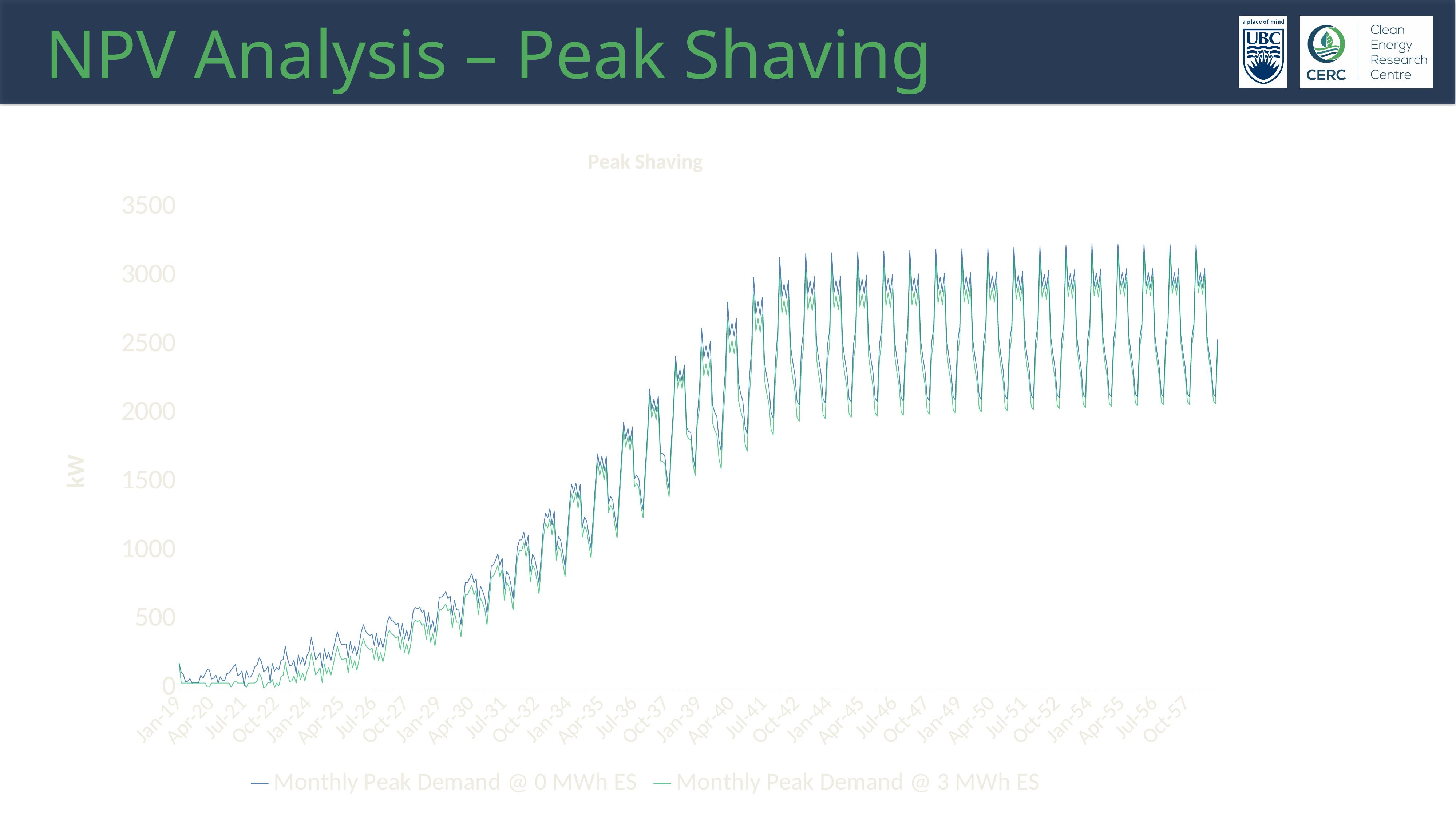
What kind of chart is shown on the slide? line chart How many series does the legend of the Peak Shaving chart list? 2 Is the value for Monthly Peak Demand @ 0 MWh ES at Oct-27 greater or less than 1000? less Are the highest peaks of Monthly Peak Demand @ 0 MWh ES after Oct-42 greater or less than 3000? greater Which series in the Peak Shaving chart reaches the highest peak values? Monthly Peak Demand @ 0 MWh ES Which series is generally lower in the Peak Shaving chart, Monthly Peak Demand @ 0 MWh ES or Monthly Peak Demand @ 3 MWh ES? Monthly Peak Demand @ 3 MWh ES Is the value for Monthly Peak Demand @ 0 MWh ES at Jan-39 greater or less than 1500? greater What is the title of the chart on the slide? Peak Shaving Do the values in the Peak Shaving chart rise or fall from Jan-19 to Jan-39? rise What unit is shown on the y-axis of the Peak Shaving chart? kW